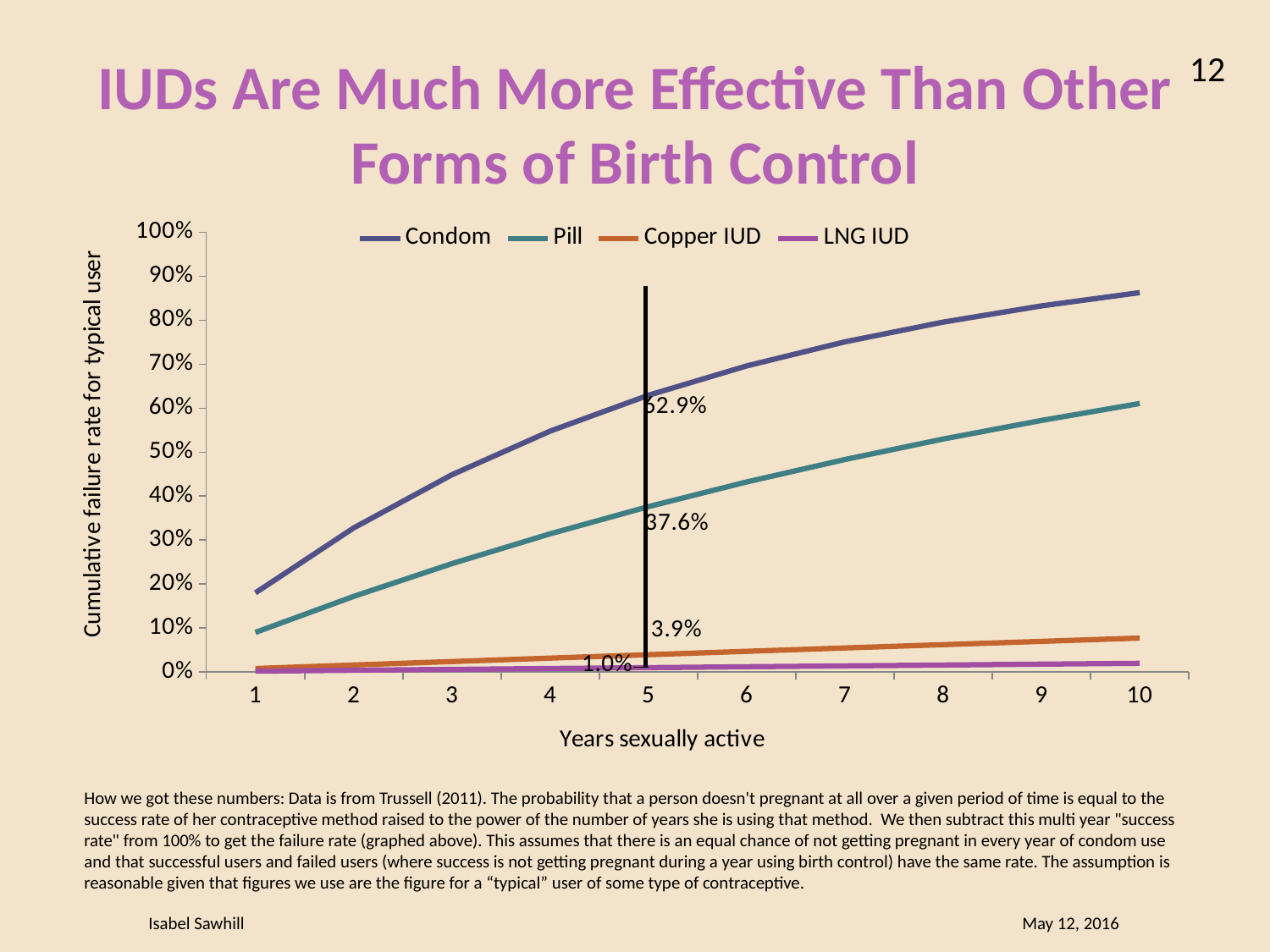
How many series does the chart legend list? 4 Which method has the highest cumulative failure rate at 5 years? Condom How many years are shown on the x axis of the chart? 10 What is the difference between the Condom and Pill cumulative failure rates at 5 years? 25.3% What is the cumulative failure rate for Condom at 5 years sexually active? 62.9% What is the cumulative failure rate for LNG IUD at 5 years sexually active? 1.0% Is the cumulative failure rate for Condom at 10 years greater or less than 80%? greater What is the cumulative failure rate for Pill at 5 years sexually active? 37.6% Which method has the lowest cumulative failure rate at 5 years? LNG IUD What type of chart is shown on the slide? line chart Does the cumulative failure rate for Pill rise or fall as years sexually active increase? rise What is the cumulative failure rate for Copper IUD at 5 years sexually active? 3.9%